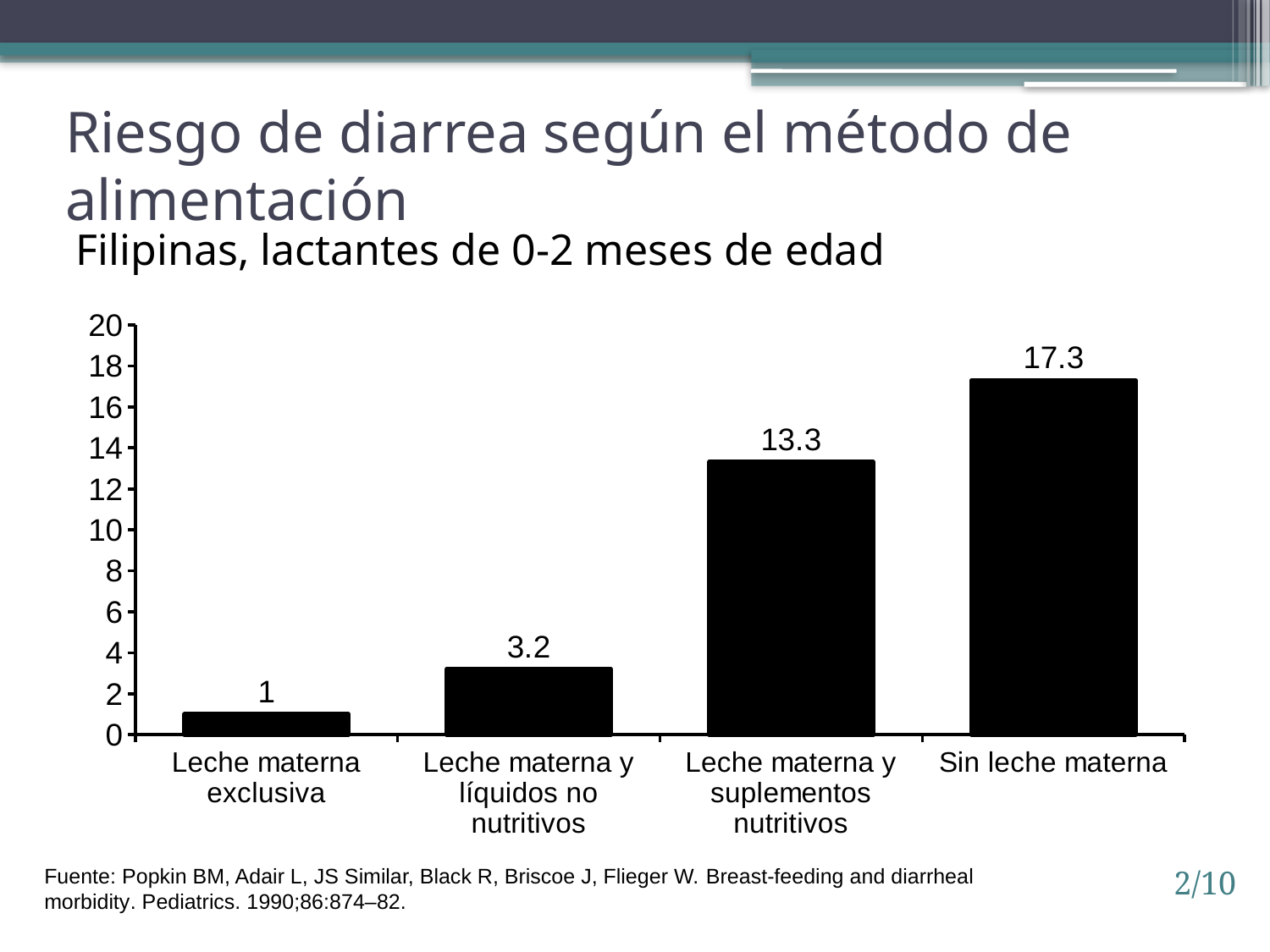
Which is larger, the value for Leche materna y líquidos no nutritivos or the value for Leche materna y suplementos nutritivos? Leche materna y suplementos nutritivos What is the value for Sin leche materna? 17.3 How many categories are shown on the x axis? 4 What is the value for Leche materna y líquidos no nutritivos? 3.2 Which category has the lowest value? Leche materna exclusiva What is the value for Leche materna exclusiva? 1 What is the value for Leche materna y suplementos nutritivos? 13.3 What is the difference between the values for Sin leche materna and Leche materna y suplementos nutritivos? 4 Do the values rise or fall from left to right along the x axis? rise Which category has the highest value? Sin leche materna What kind of chart is shown on the slide? bar chart Is the value for Sin leche materna greater or less than 16? greater